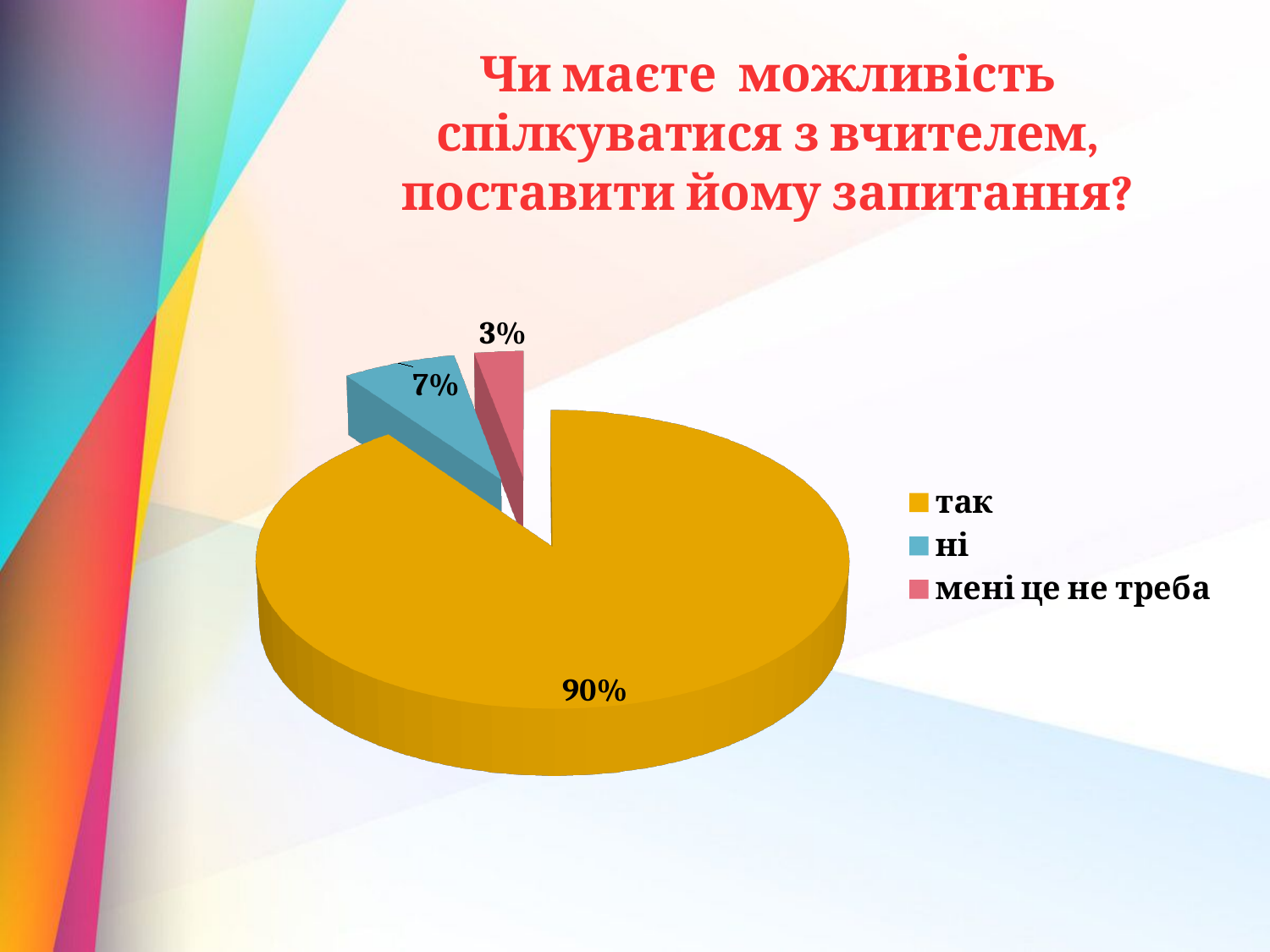
What share of the pie does "ні" have? 7% Which is larger, the share for "ні" or the share for "мені це не треба"? ні How many slices does the pie chart have? 3 What is the difference between the shares for "ні" and "мені це не треба"? 4% What share of the pie does "мені це не треба" have? 3% What is the difference between the shares for "так" and "ні"? 83% How many entries does the legend list? 3 What colour is the slice for "так"? yellow What kind of chart is shown on the slide? pie chart Which category has the smallest slice? мені це не треба What share of the pie does "так" have? 90% Which category has the largest slice? так